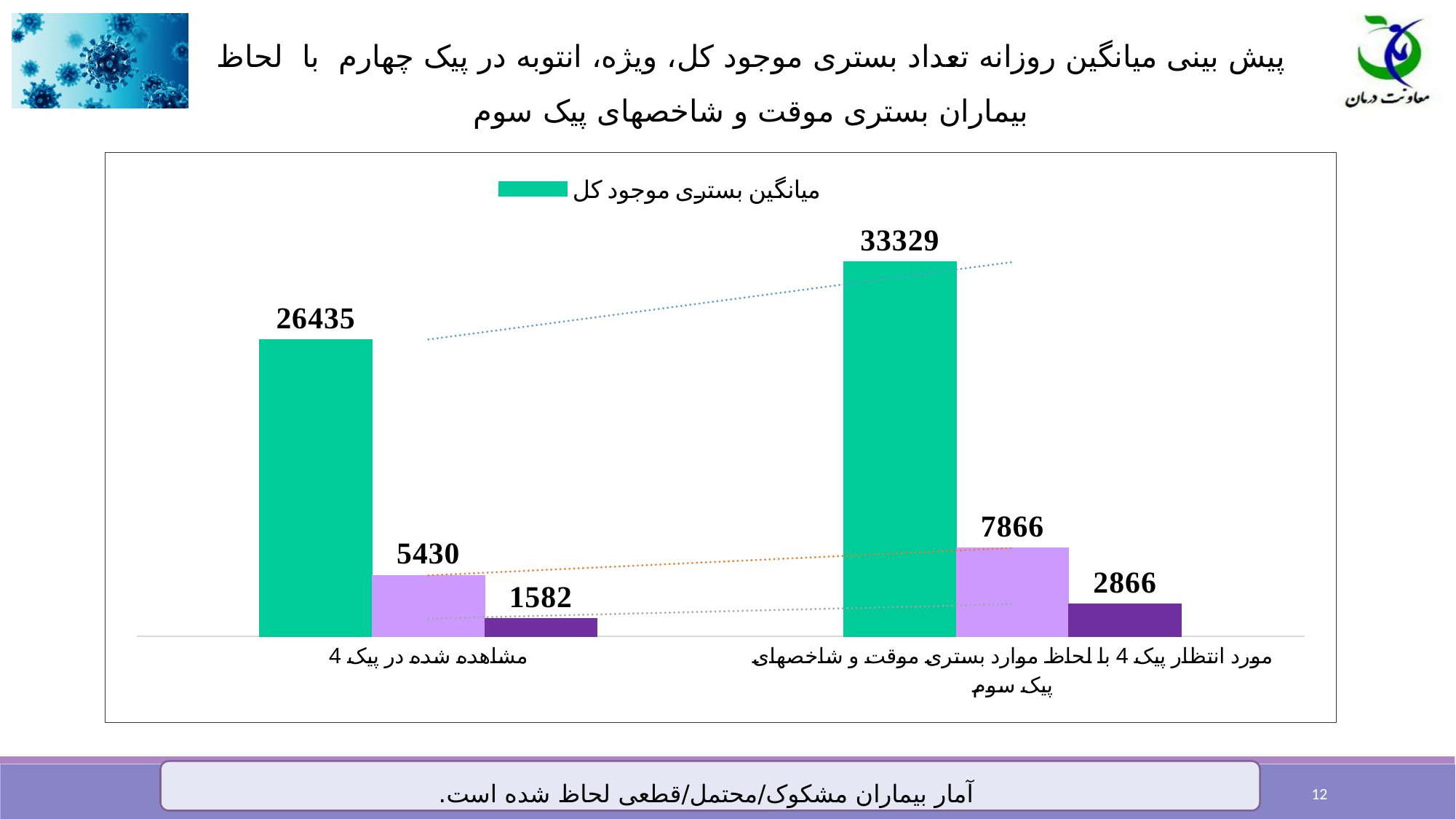
What is the value of the dark purple bar for the category 'مورد انتظار پیک 4 با لحاظ موارد بستری موقت و شاخصهای پیک سوم'? 2866 What series name is shown in the chart legend? میانگین بستری موجود کل What is the difference between the light purple bars of the two categories (7866 and 5430)? 2436 What is the smallest value labelled on the chart? 1582 What is the value of the light purple bar for the category 'مشاهده شده در پیک 4'? 5430 What type of chart is shown on the slide? bar chart What is the value of the 'میانگین بستری موجود کل' (green) bar for the category 'مشاهده شده در پیک 4'? 26435 How many categories are shown on the x axis of the chart? 2 What is the difference between the 'میانگین بستری موجود کل' values of the two categories (33329 and 26435)? 6894 How many bars are plotted for each category in the chart? 3 What is the value of the 'میانگین بستری موجود کل' (green) bar for the category 'مورد انتظار پیک 4 با لحاظ موارد بستری موقت و شاخصهای پیک سوم'? 33329 Which category has the higher 'میانگین بستری موجود کل' value? مورد انتظار پیک 4 با لحاظ موارد بستری موقت و شاخصهای پیک سوم